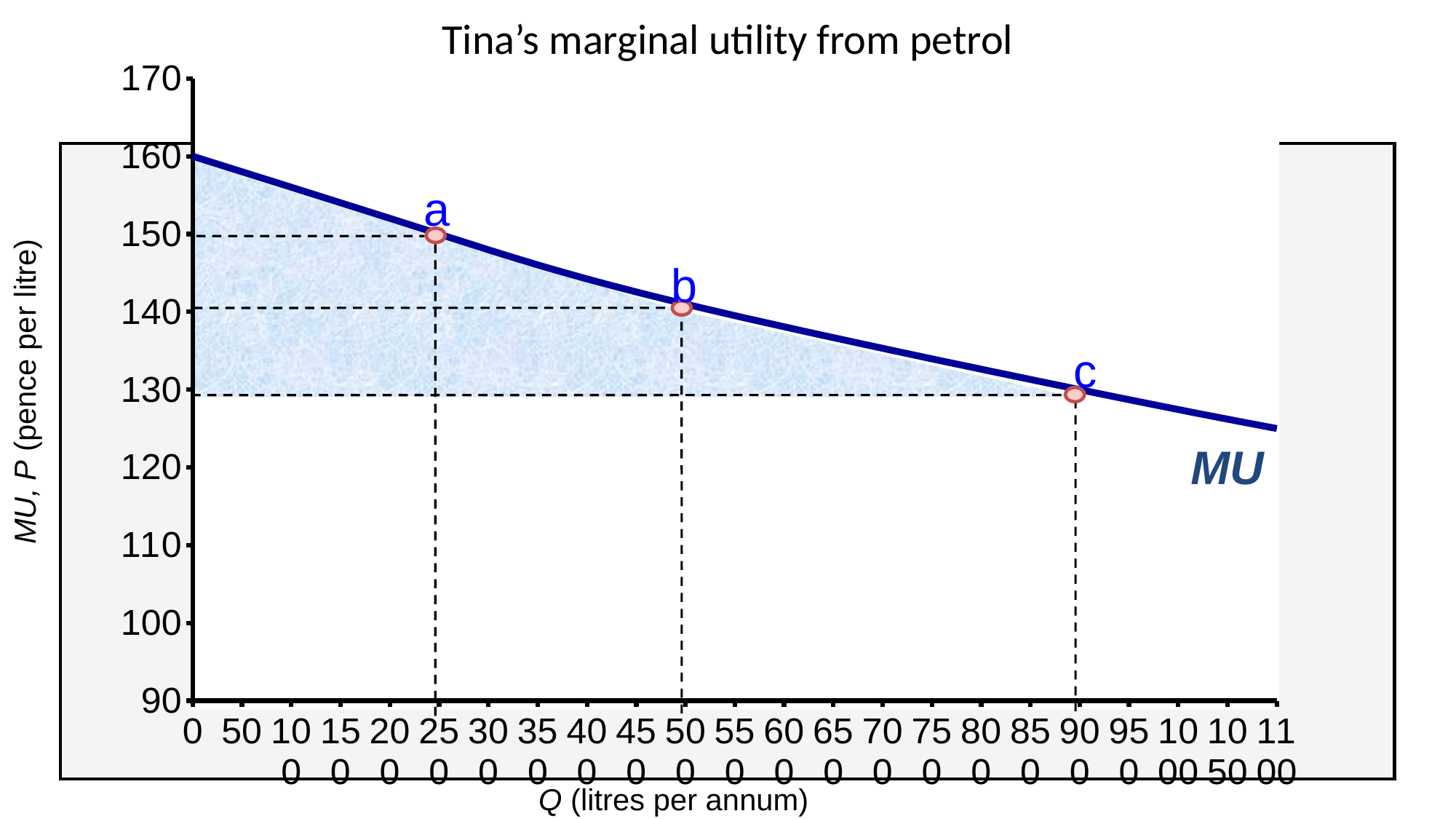
What is the marginal utility (pence per litre) at point b? 140 What is the marginal utility (pence per litre) at point c? 130 What is the difference in marginal utility between point a and point c? 20 What is the marginal utility (pence per litre) at point a? 150 How many labelled points are marked on the MU curve? 3 Does the MU curve rise or fall as Q increases? fall Is the marginal utility at Q = 0 greater or less than 150? greater At what quantity Q (litres per annum) is point a located? 250 Which point has the higher marginal utility, b or c? b What kind of chart is shown on the slide? line chart At what quantity Q (litres per annum) is point c located? 900 What is the title of the chart? Tina's marginal utility from petrol